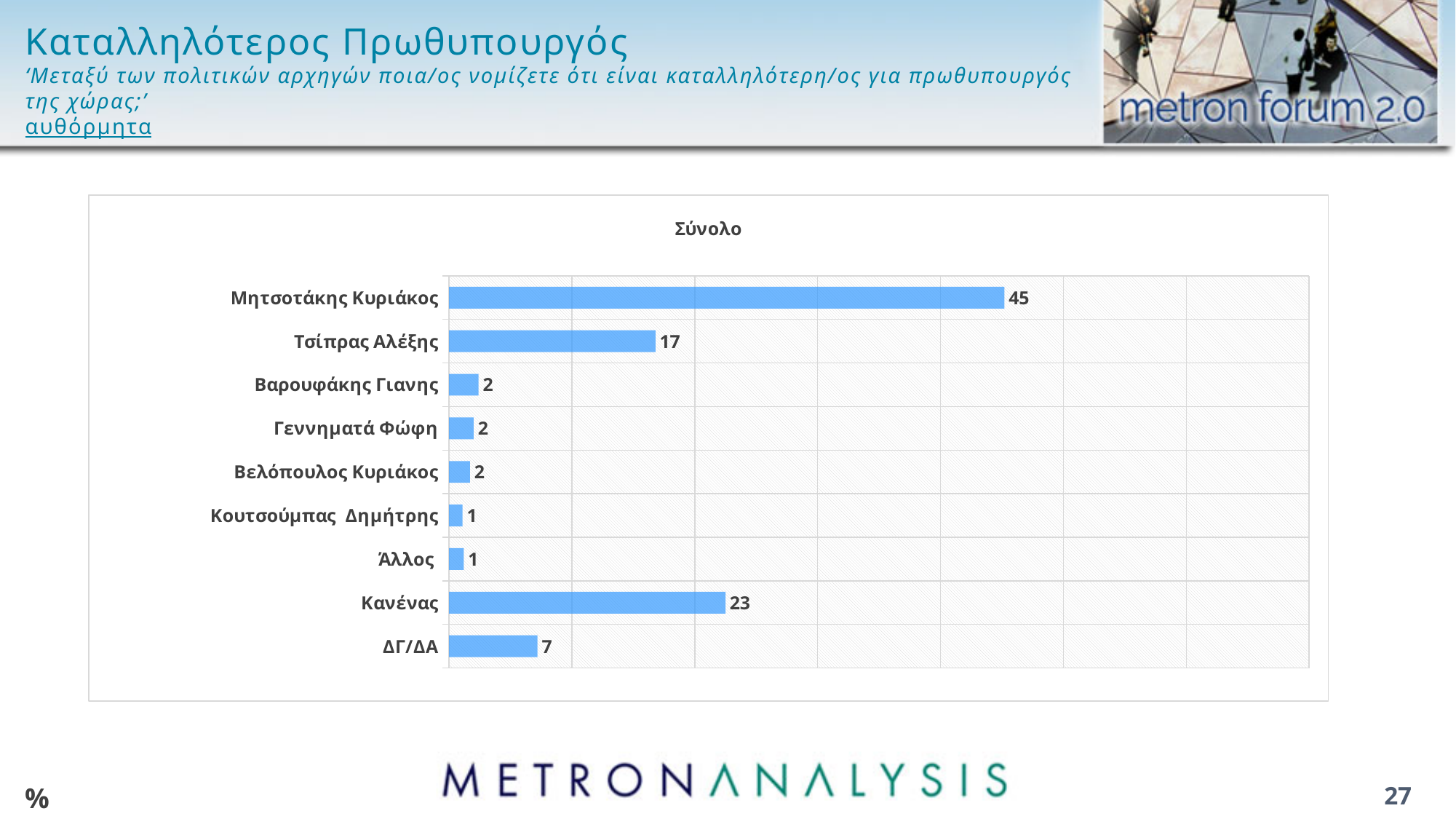
What is the value for Τσίπρας Αλέξης? 17 What is the value for Κανένας? 23 How many categories are shown in the chart? 9 What is the difference between the values for Μητσοτάκης Κυριάκος and Τσίπρας Αλέξης? 28 What is the value for ΔΓ/ΔΑ? 7 What is the difference between the values for Κανένας and ΔΓ/ΔΑ? 16 What kind of chart is shown on the slide? bar chart What is the title of the chart? Σύνολο Which category has the highest value? Μητσοτάκης Κυριάκος What is the value for Μητσοτάκης Κυριάκος? 45 What is the value for Κουτσούμπας Δημήτρης? 1 Which is larger, the value for Κανένας or the value for Τσίπρας Αλέξης? Κανένας